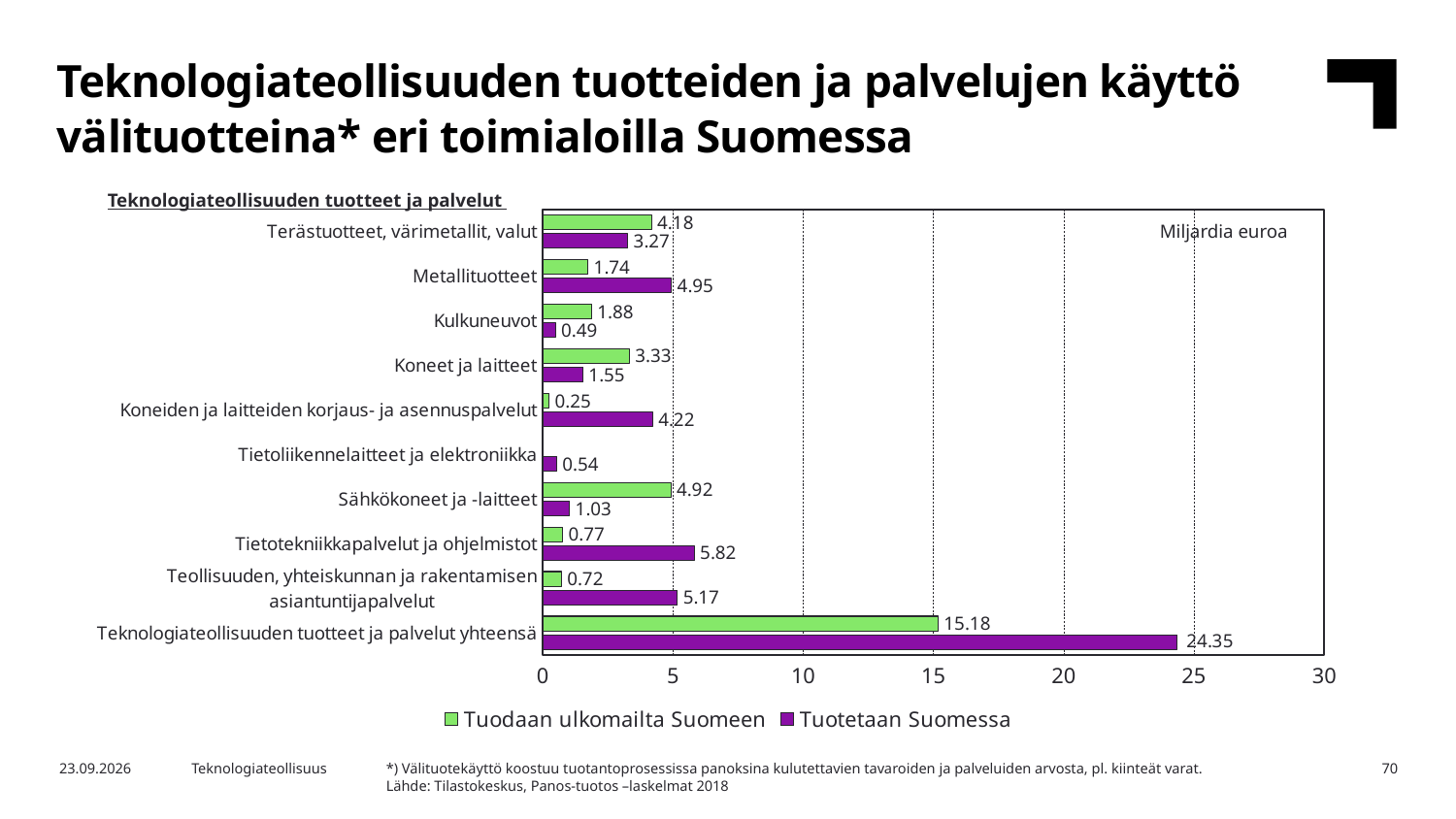
What is the value of 'Tuotetaan Suomessa' for Teknologiateollisuuden tuotteet ja palvelut yhteensä? 24.35 What is the value of 'Tuotetaan Suomessa' for Tietotekniikkapalvelut ja ohjelmistot? 5.82 For Kulkuneuvot, which is larger: 'Tuodaan ulkomailta Suomeen' or 'Tuotetaan Suomessa'? Tuodaan ulkomailta Suomeen What unit is stated in the chart for the values? Miljardia euroa How many series does the legend list? 2 What type of chart is shown on the slide? Bar chart Excluding the total row, which category has the highest 'Tuotetaan Suomessa' value? Tietotekniikkapalvelut ja ohjelmistot What is the value of 'Tuodaan ulkomailta Suomeen' for Sähkökoneet ja -laitteet? 4.92 How many categories are shown on the vertical axis of the chart? 10 Is the 'Tuodaan ulkomailta Suomeen' value for Teknologiateollisuuden tuotteet ja palvelut yhteensä greater or less than 20? less What is the difference between the 'Tuotetaan Suomessa' and 'Tuodaan ulkomailta Suomeen' values for Metallituotteet? 3.21 Excluding the total row, which category has the lowest 'Tuodaan ulkomailta Suomeen' value among those with a printed label? Koneiden ja laitteiden korjaus- ja asennuspalvelut